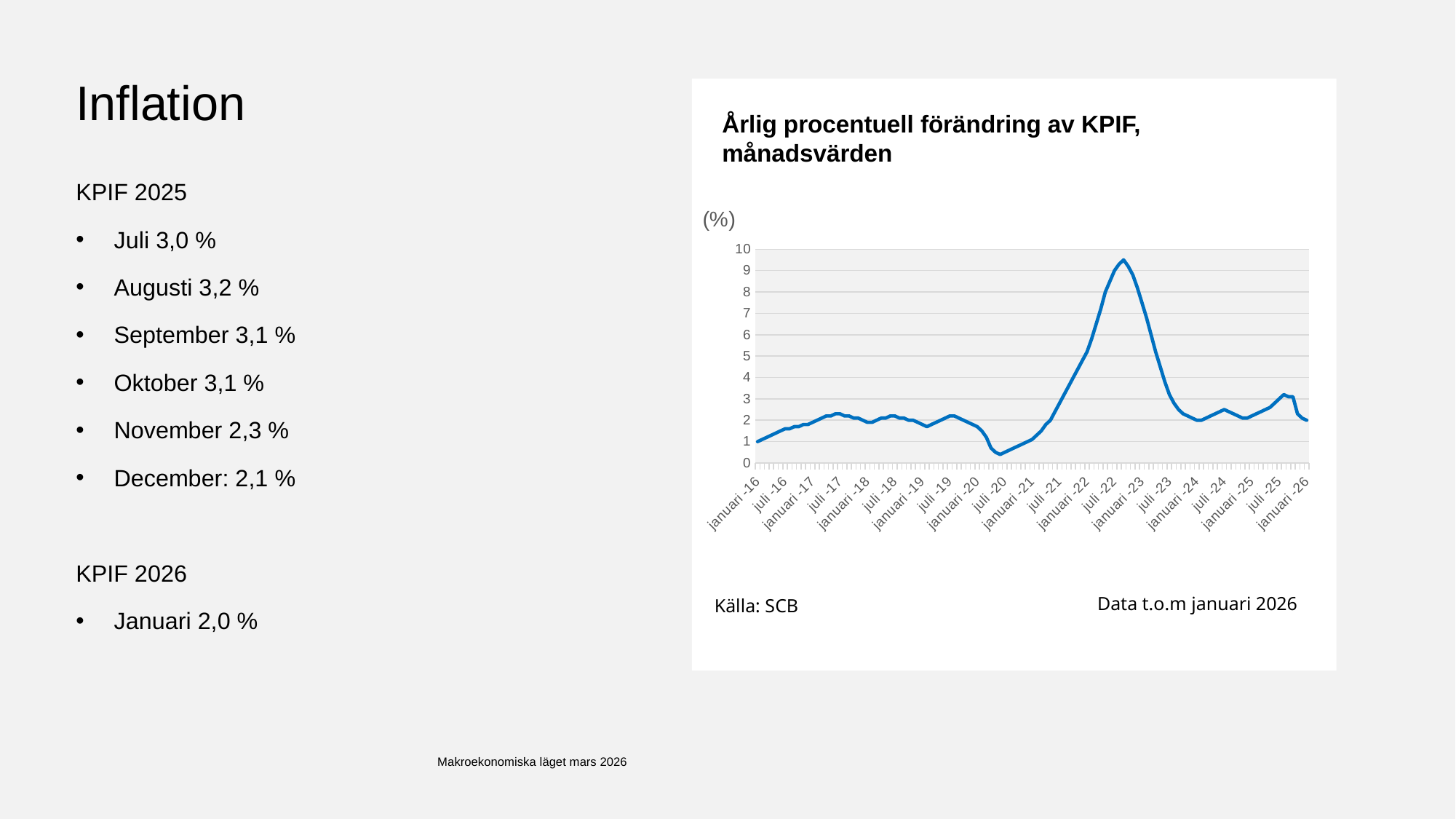
Is the value at juli -20 greater or less than 1? less What is the title of the chart? Årlig procentuell förändring av KPIF, månadsvärden Which is larger, the value at juli -22 or the value at juli -20? juli -22 What unit is shown on the y axis of the chart? (%) Is the peak value of the line greater or less than 8? greater How many x-axis labels are shown on the chart? 21 How many data series are plotted on the chart? 1 Around which x-axis label does the line reach its lowest value? juli -20 What kind of chart is shown on the slide? line chart Does the line rise or fall between juli -20 and juli -22? rise Around which x-axis label does the line reach its highest value? juli -22 Is the value at juli -17 greater or less than 2? greater